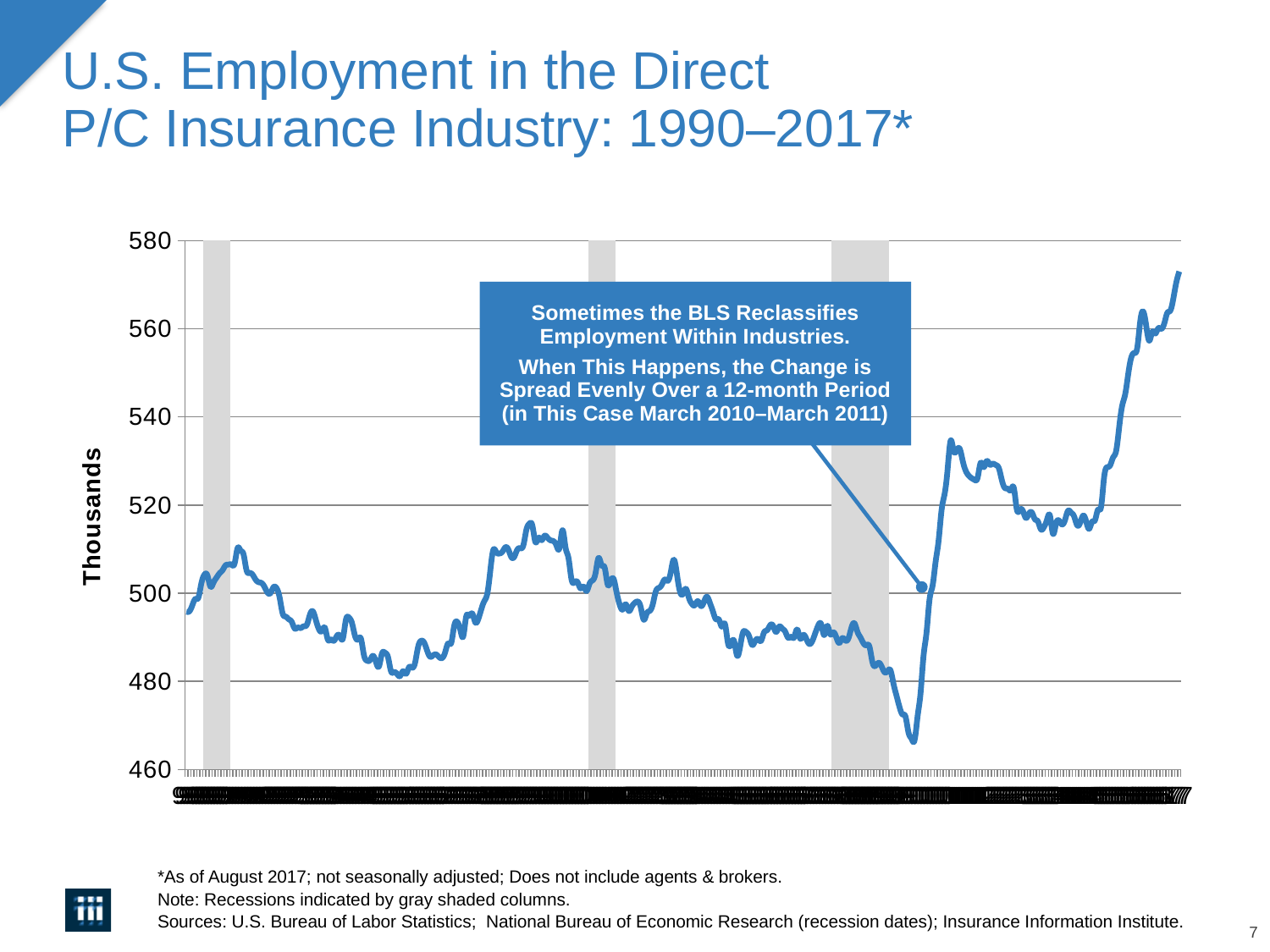
Is the value at the end of the series higher or lower than the value at the start of the series? higher What is the label on the vertical axis of the chart? Thousands Is the highest point of the line greater or less than 560? greater What kind of chart is shown on the slide? line chart How many lines are plotted on the chart? 1 Is the value at the start of the line (1990) greater or less than 500? less Overall, does the line rise or fall from the left end of the chart to the right end? rise Is the value at the far right end of the line (August 2017) greater or less than 560? greater How many gray shaded recession columns appear on the chart? 3